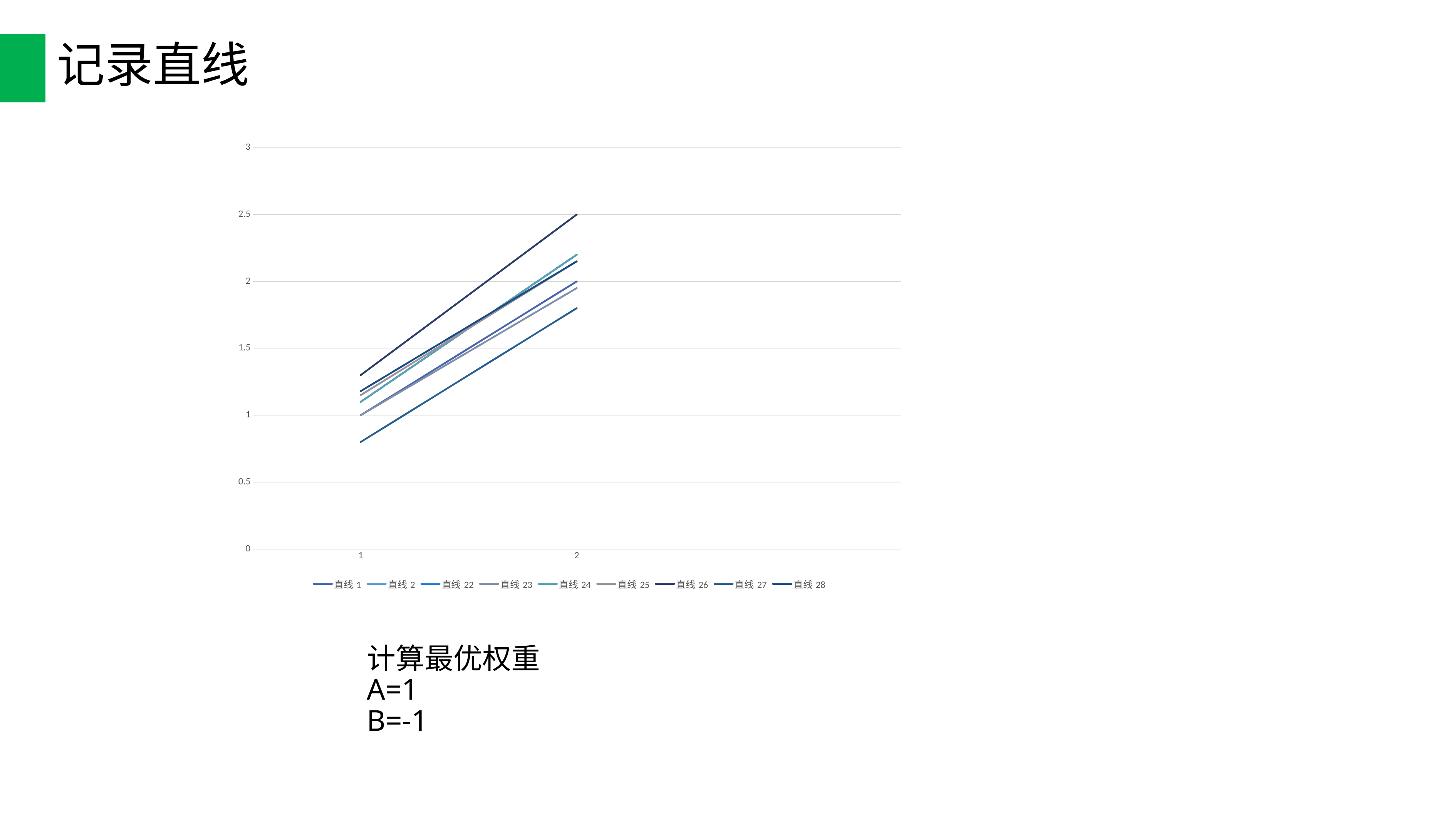
Do the lines in the chart rise or fall from x = 1 to x = 2? rise What is the maximum value shown on the y axis of the chart? 3 Is the highest line's value at x = 2 greater or less than 2? greater Is the lowest line's value at x = 2 greater or less than 1.5? greater What is the first series name listed in the chart legend? 直线 1 How many points are there along the x axis of the chart? 2 How many series does the legend of the chart list? 9 What is the highest value reached by any line at x = 2 in the chart? 2.5 What kind of chart is shown on the slide? line chart Do any of the lines in the chart reach the value 3? no What is the last series name listed in the chart legend? 直线 28